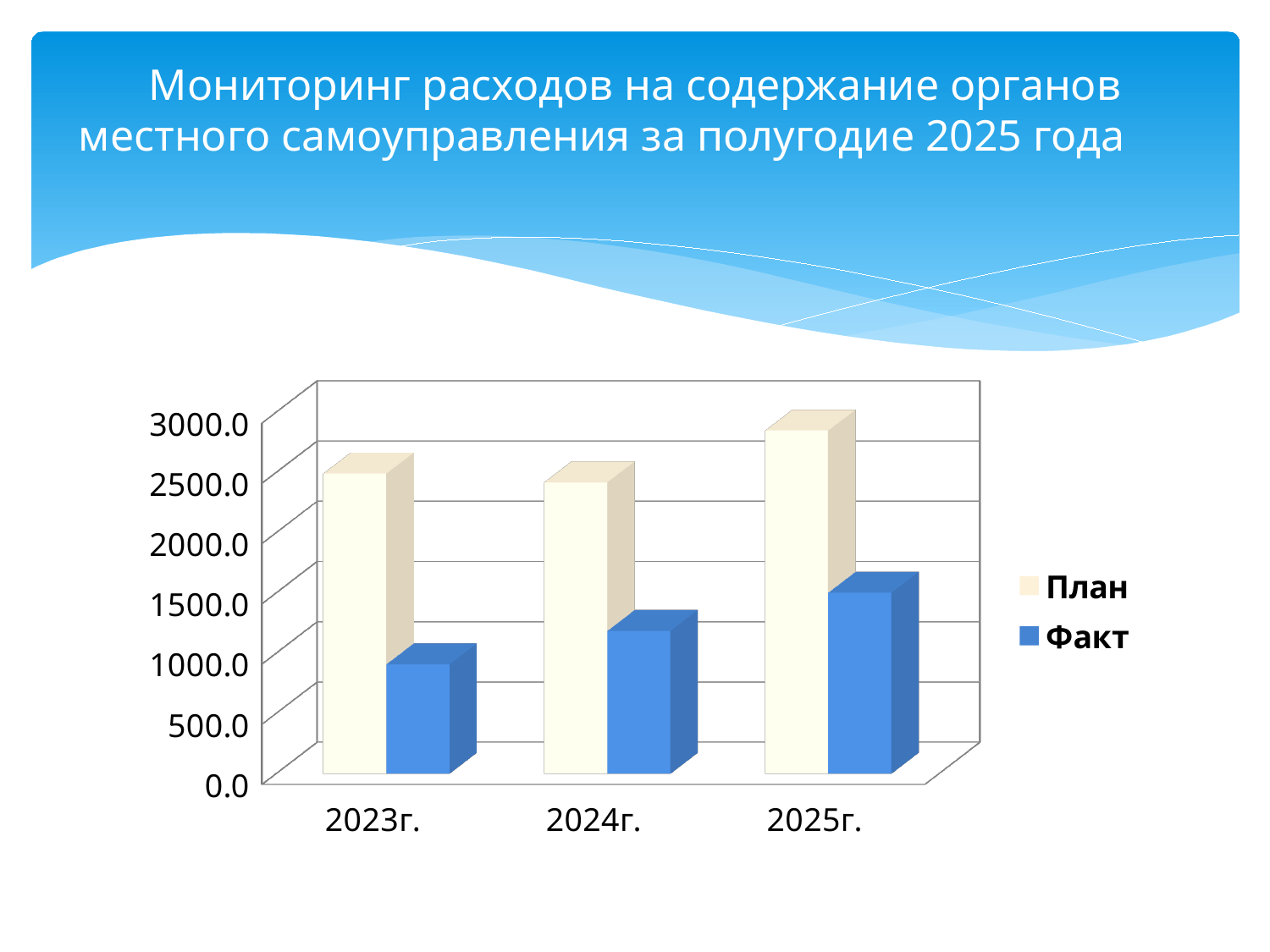
In which year is the Факт value highest? 2025г. Do the Факт values rise or fall from 2023г. to 2025г.? rise In which year is the Факт value lowest? 2023г. Which is larger in 2023г., План or Факт? План What are the two series named in the legend? План and Факт In which year is the План value highest? 2025г. How many series does the legend list? 2 Is the Факт value for 2023г. greater or less than 1500.0? less Is the План value for 2025г. greater or less than 2500.0? greater How many year categories are shown on the x axis? 3 Which series is drawn in blue? Факт What kind of chart is shown on the slide? bar chart